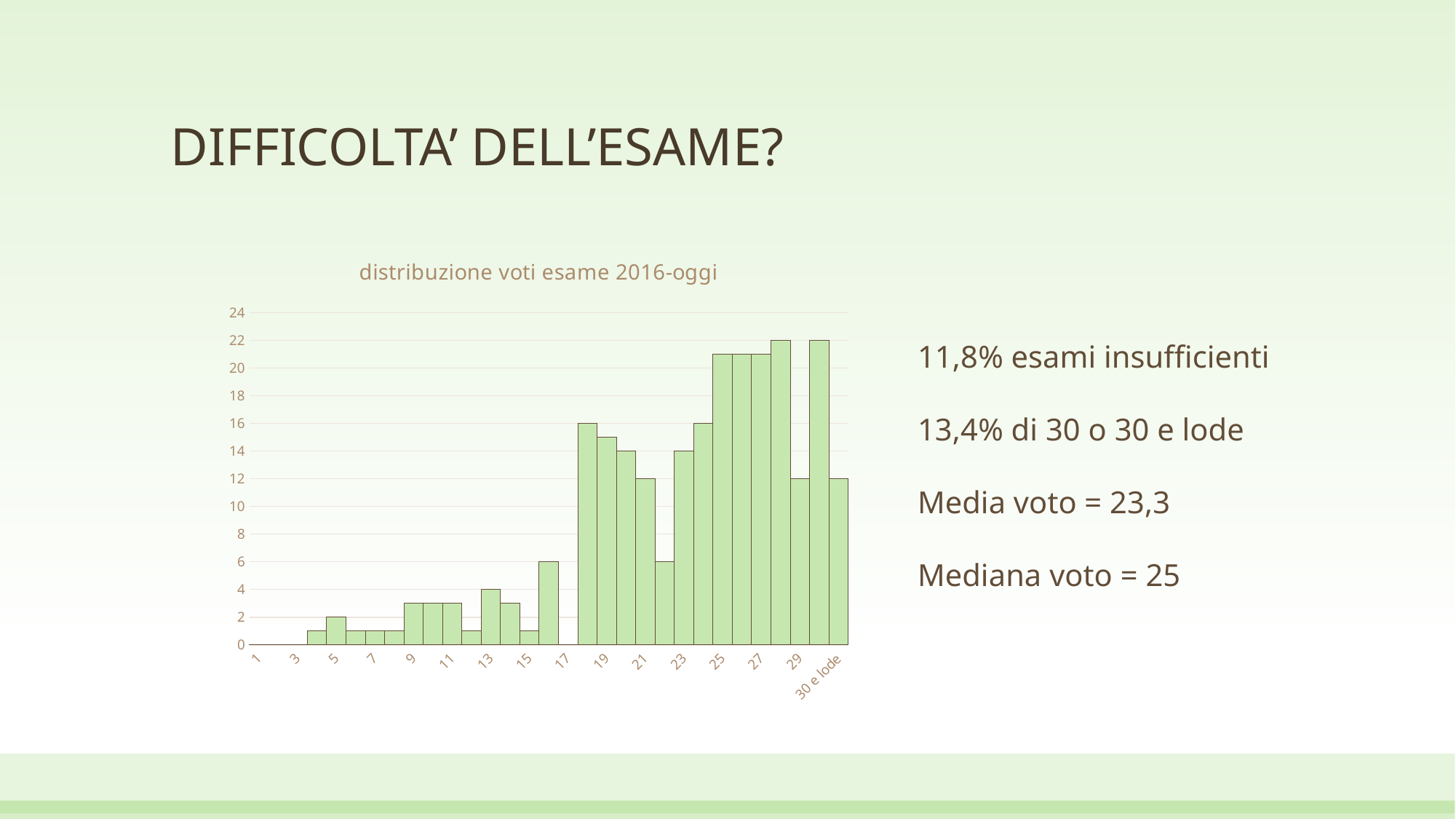
Is the value for grade 13 greater or less than 6? less What is the highest value reached by any bar in the chart? 22 What kind of chart is shown on the slide? bar chart What is the value for the category "30 e lode"? 12 What is the title of the chart? distribuzione voti esame 2016-oggi What is the value for grade 30? 22 What is the value for grade 22? 6 What is the difference between the value for grade 30 and the value for "30 e lode"? 10 Which has the larger value, grade 24 or grade 22? 24 Is the value for grade 25 greater or less than 20? greater What is the value for grade 18? 16 What is the value for grade 17? 0